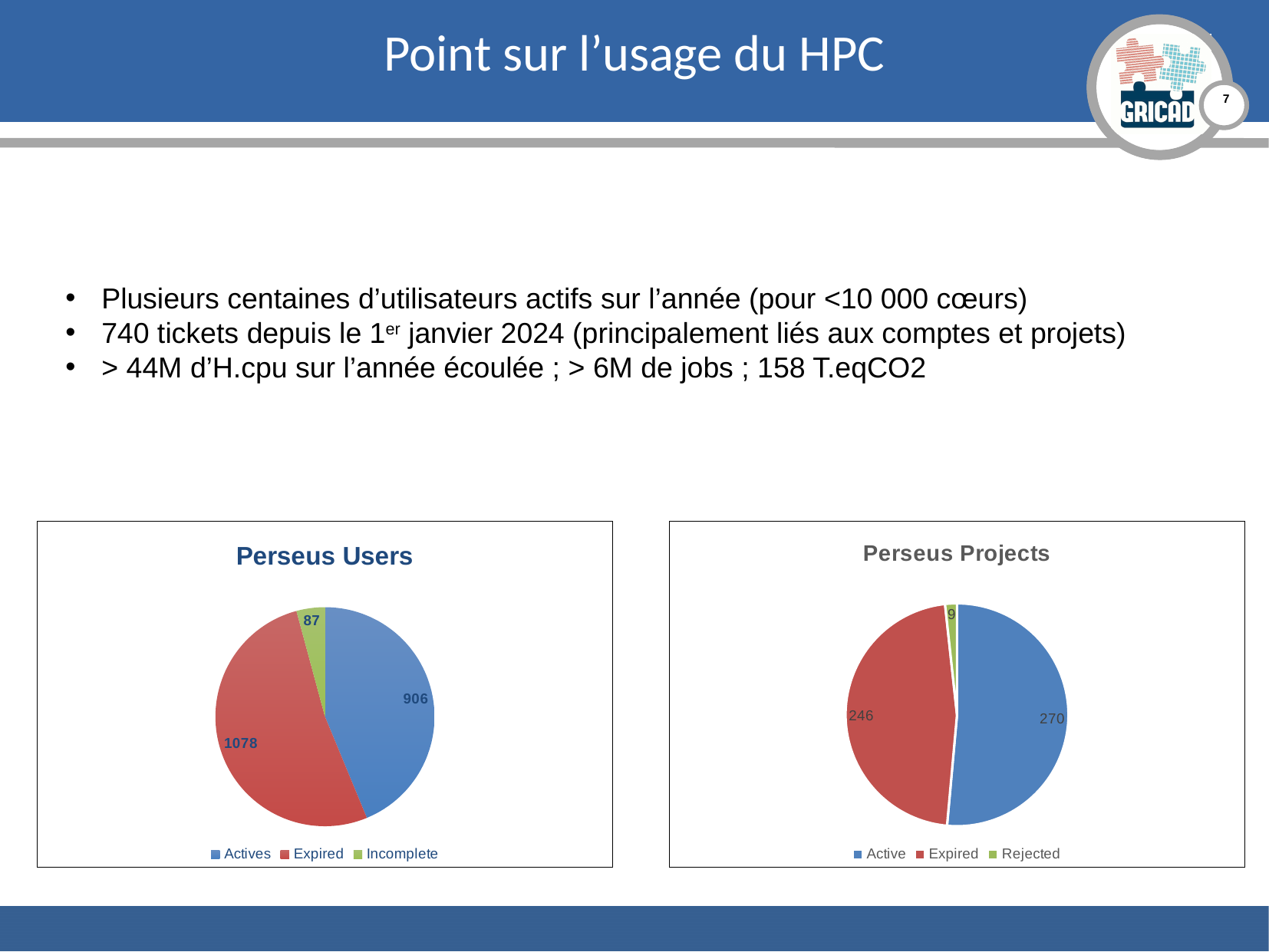
In the Perseus Users chart, what is the value for Expired? 1078 In the Perseus Projects chart, which category has the smallest slice? Rejected In the Perseus Users chart, which category has the largest slice? Expired What is the total of all slices in the Perseus Projects chart? 525 In the Perseus Projects chart, what is the value for Rejected? 9 In the Perseus Users chart, what is the value for Incomplete? 87 In the Perseus Projects chart, what is the value for Active? 270 In the Perseus Users chart, what is the difference between Expired and Actives? 172 In the Perseus Users chart, which is larger, Actives or Incomplete? Actives How many categories does the Perseus Projects chart show? 3 What kind of chart is the Perseus Users chart? Pie chart In the Perseus Projects chart, what is the difference between Active and Expired? 24